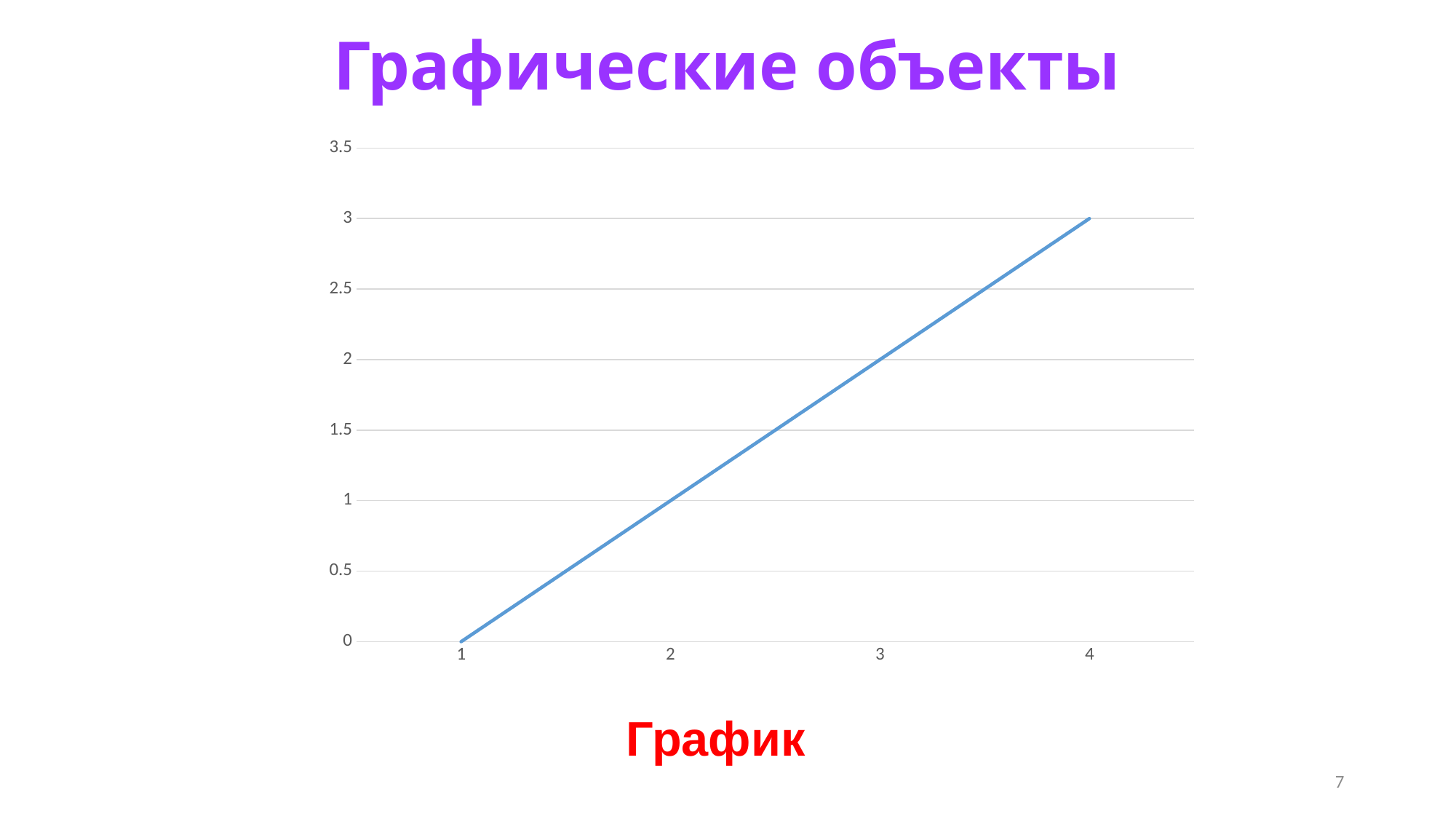
What is the value of the line at x = 2? 1 How many x-axis categories are shown on the chart? 4 What is the value of the line at x = 3? 2 Which is larger, the value at x = 3 or the value at x = 2? x = 3 Do the values rise or fall as the x axis goes from 1 to 4? rise What is the value of the line at x = 1? 0 What is the red caption written below the chart? График What is the value of the line at x = 4? 3 At which x value is the line highest? 4 What is the difference between the value at x = 4 and the value at x = 2? 2 What kind of chart is shown on the slide? line chart At which x value is the line lowest? 1